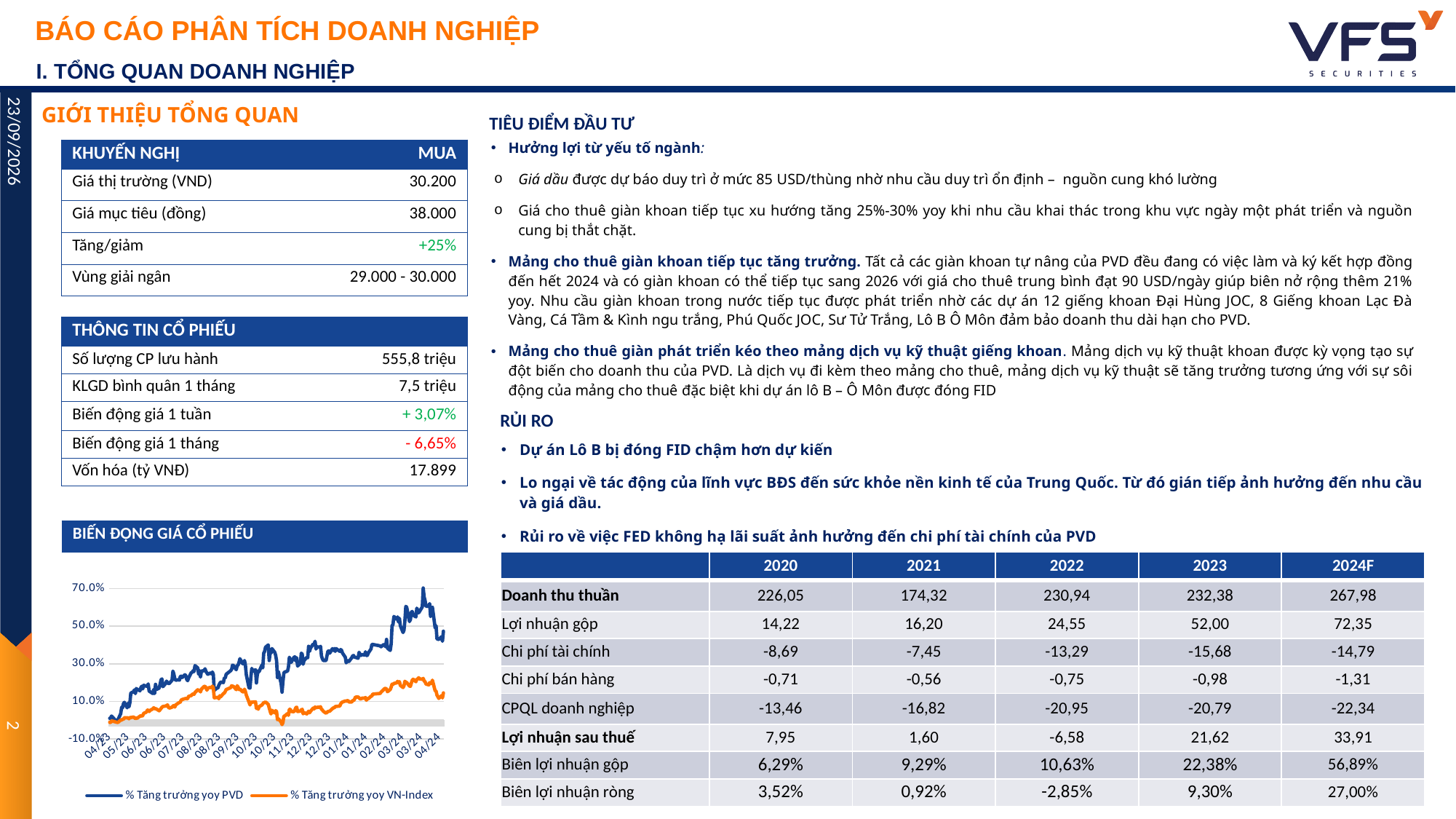
What kind of chart is shown under "BIẾN ĐỘNG GIÁ CỔ PHIẾU"? Line chart In the "BIẾN ĐỘNG GIÁ CỔ PHIẾU" chart, is the peak value of % Tăng trưởng yoy VN-Index greater or less than 30.0%? less In the "BIẾN ĐỘNG GIÁ CỔ PHIẾU" chart, does % Tăng trưởng yoy PVD overall rise or fall from 04/23 to 04/24? Rise In the "BIẾN ĐỘNG GIÁ CỔ PHIẾU" chart, is the lowest value of % Tăng trưởng yoy VN-Index around 11/23 greater or less than 10.0%? less In the "BIẾN ĐỘNG GIÁ CỔ PHIẾU" chart, is the peak value of % Tăng trưởng yoy PVD greater or less than 50.0%? greater In the "BIẾN ĐỘNG GIÁ CỔ PHIẾU" chart, which series is drawn in orange? % Tăng trưởng yoy VN-Index In the "BIẾN ĐỘNG GIÁ CỔ PHIẾU" chart, which series is drawn in blue? % Tăng trưởng yoy PVD How many series does the legend of the "BIẾN ĐỘNG GIÁ CỔ PHIẾU" chart list? 2 In the "BIẾN ĐỘNG GIÁ CỔ PHIẾU" chart, which series is higher at 04/24, % Tăng trưởng yoy PVD or % Tăng trưởng yoy VN-Index? % Tăng trưởng yoy PVD